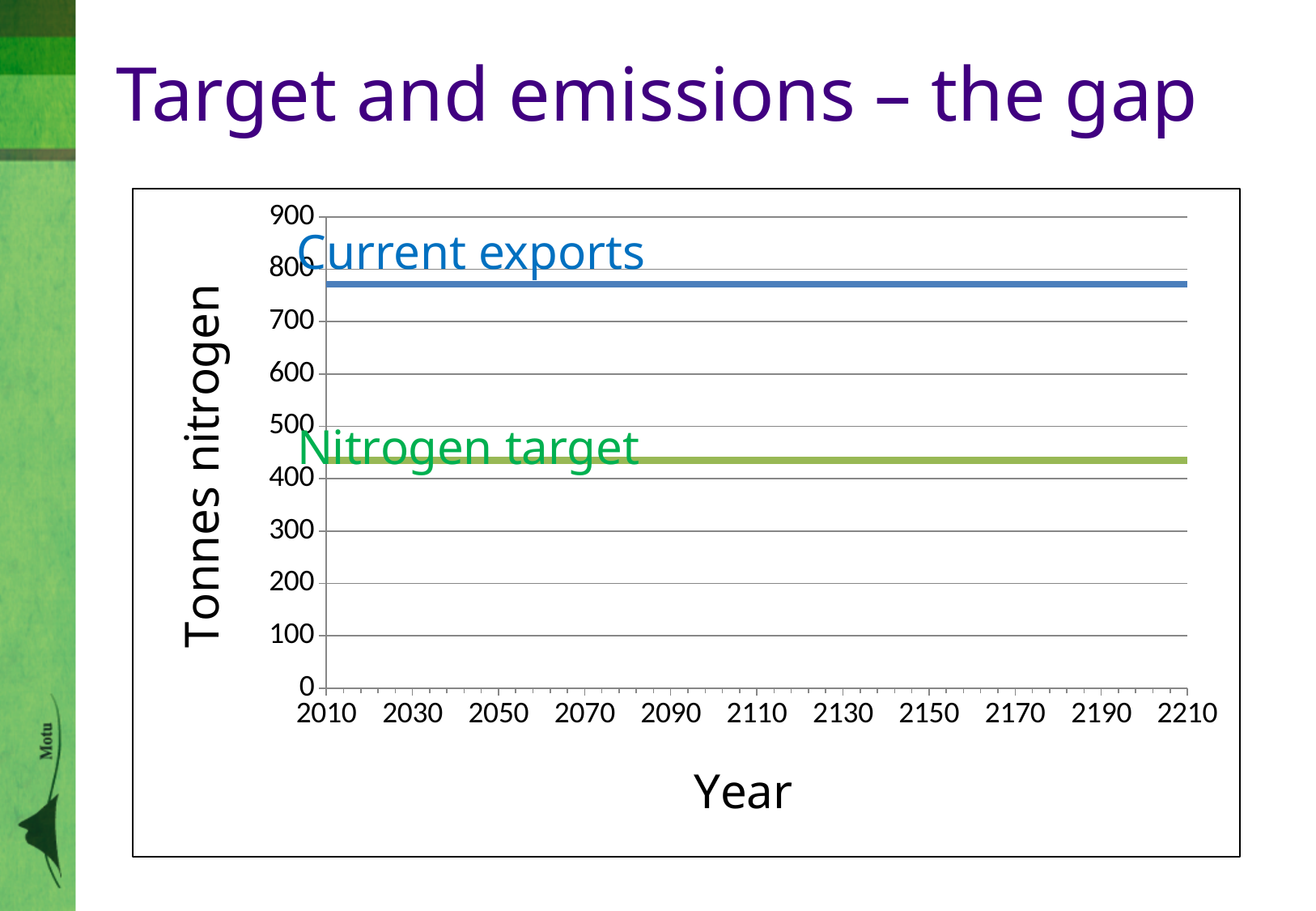
What kind of chart is shown on the slide? line chart Is the value for Current exports greater or less than 700? greater Do the Nitrogen target values rise, fall or stay flat across the years shown? stay flat What is the label of the vertical axis? Tonnes nitrogen How many series are plotted on the chart? 2 Is the value for Nitrogen target greater or less than 500? less Is the value for Current exports greater or less than 800? less Which series is higher, Current exports or Nitrogen target? Current exports What is the title of the slide? Target and emissions – the gap Do the Current exports values rise, fall or stay flat across the years shown? stay flat